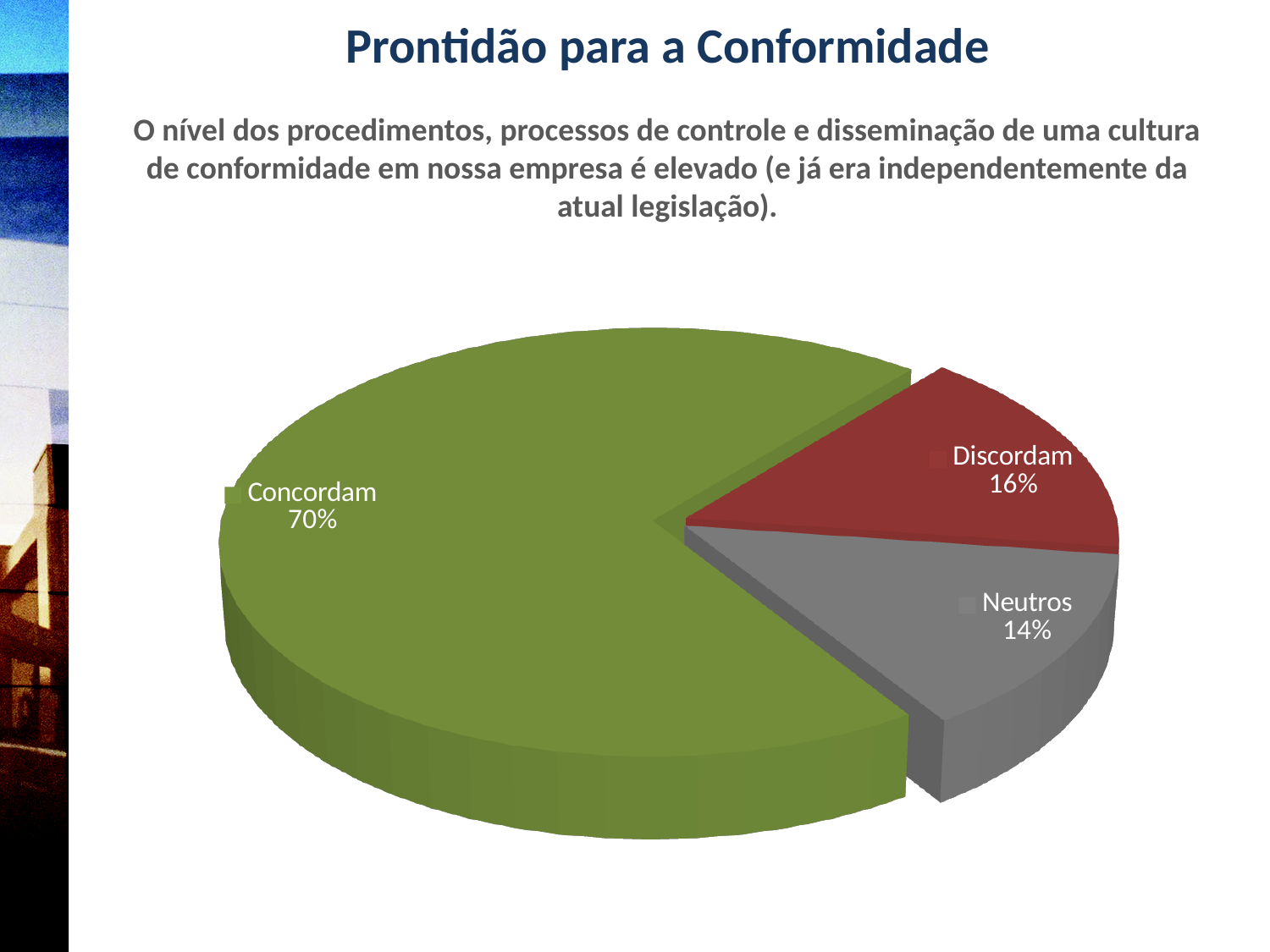
What is the combined share of Discordam and Neutros? 30% What kind of chart is shown on the slide? Pie chart Which is larger, the Discordam slice or the Neutros slice? Discordam What colour is the Concordam slice? Green What is the value shown for Discordam? 16% Which category has the smallest slice of the pie? Neutros Which category has the largest slice of the pie? Concordam What share of the pie does Concordam represent? 70% How many categories are shown in the pie chart? 3 What is the difference between the Discordam and Neutros shares? 2% What is the difference between the Concordam and Discordam shares? 54% What is the value shown for Neutros? 14%